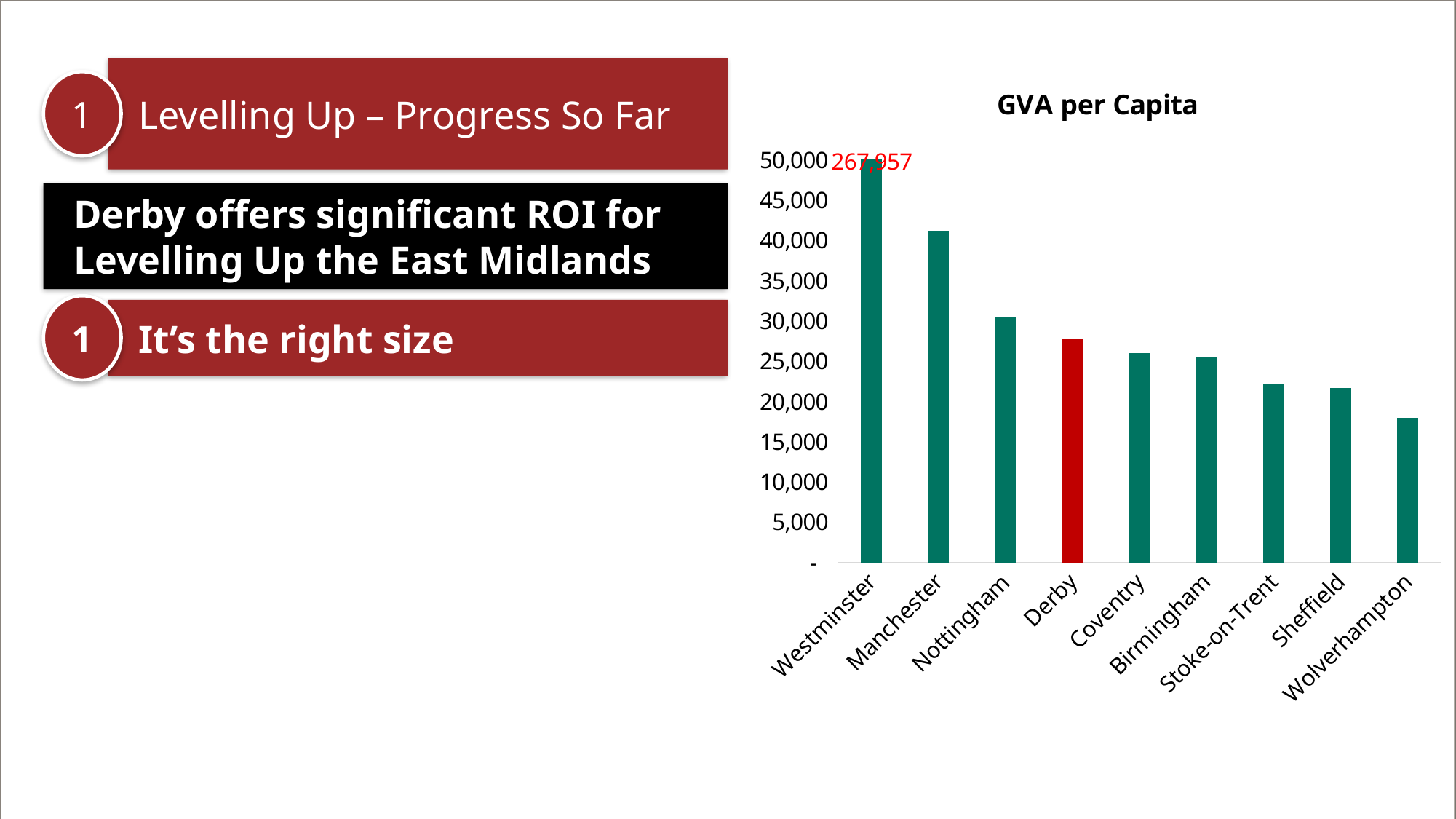
Do the GVA per Capita values rise or fall from left to right across the cities? Fall Is the GVA per Capita value for Wolverhampton greater or less than 20,000? less Which city has the lowest GVA per Capita? Wolverhampton Is the GVA per Capita value for Derby greater or less than 25,000? greater How many cities are shown on the GVA per Capita chart? 9 Which city's bar is coloured red on the GVA per Capita chart? Derby Is the GVA per Capita value for Nottingham greater or less than 35,000? less What is the GVA per Capita value shown for Westminster? 267,957 What kind of chart is used to show GVA per Capita? Bar chart Which has a higher GVA per Capita, Manchester or Nottingham? Manchester Which city has the highest GVA per Capita? Westminster Which has a higher GVA per Capita, Sheffield or Wolverhampton? Sheffield